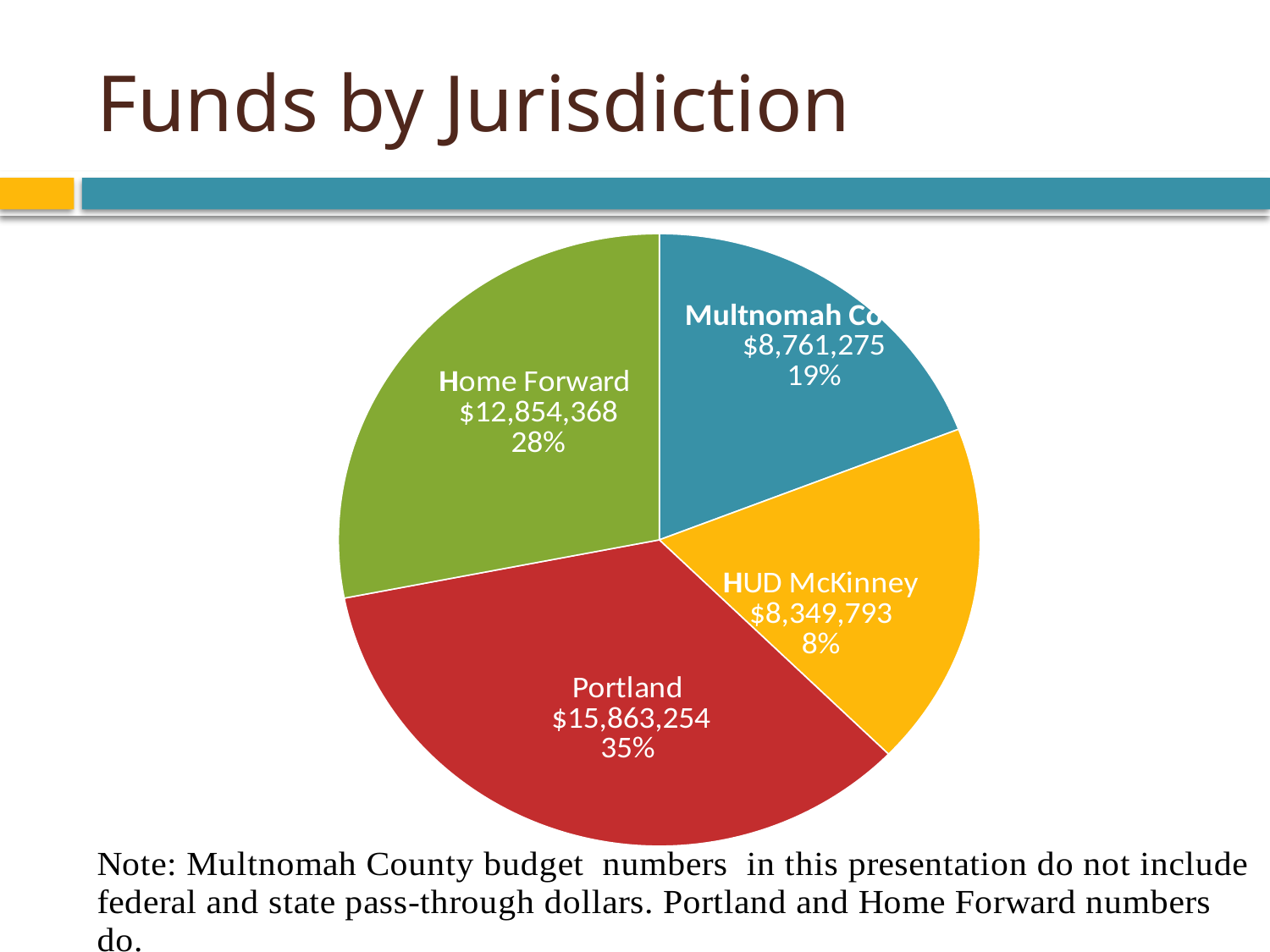
What is the dollar value shown for HUD McKinney? $8,349,793 Which jurisdiction has the largest share of funds? Portland Which has a larger dollar value, Multnomah County or HUD McKinney? Multnomah County What is the difference in dollars between Portland and Home Forward? $3,008,886 What type of chart is shown on the slide? Pie chart What is the title of the slide's chart? Funds by Jurisdiction What is the dollar value shown for Home Forward? $12,854,368 How many slices does the pie chart have? 4 What is the dollar value shown for Portland? $15,863,254 What is the dollar value shown for Multnomah County? $8,761,275 What percentage share of funds is shown for Home Forward? 28% Which jurisdiction has the smallest dollar value of funds? HUD McKinney